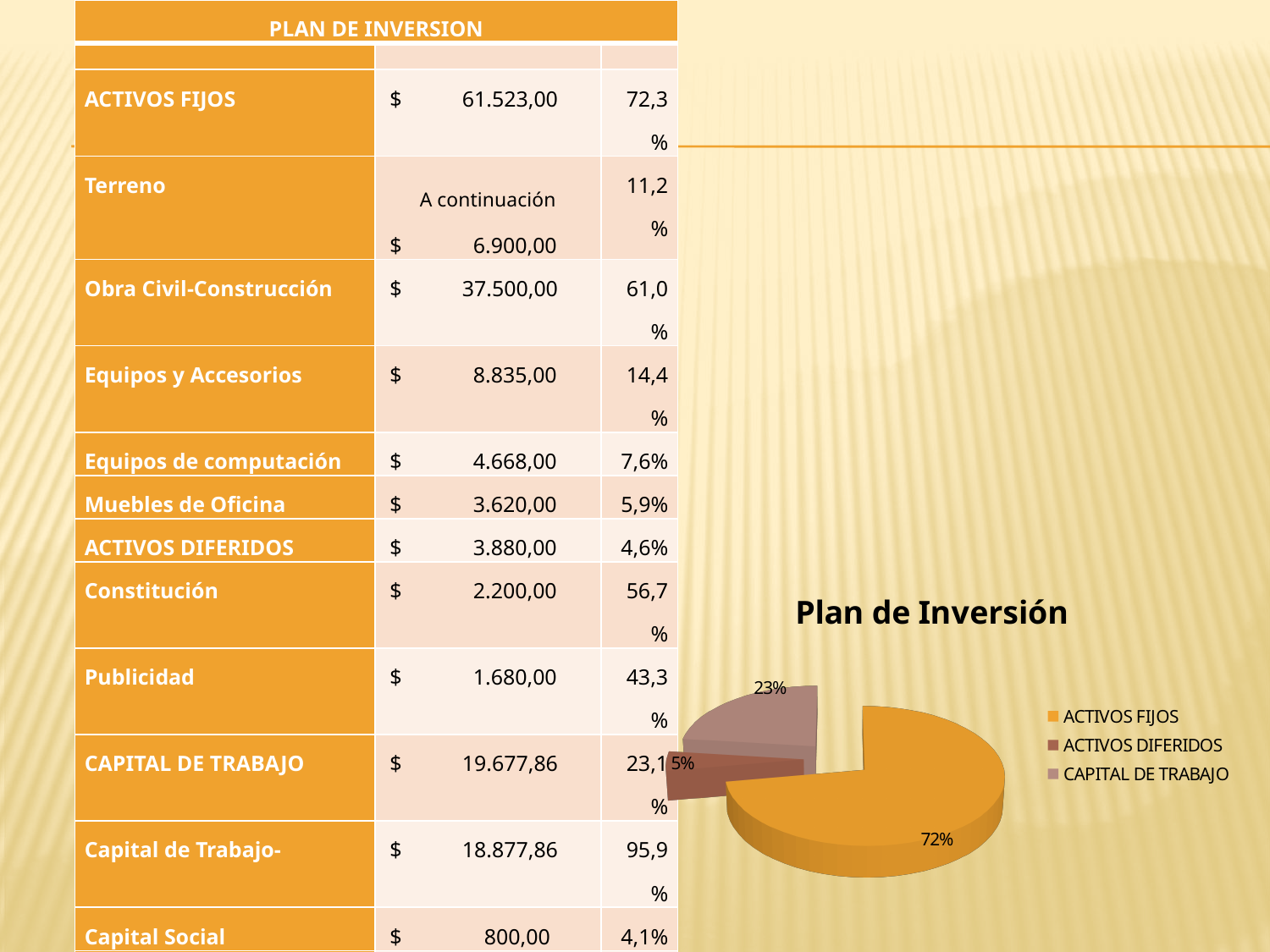
How many entries does the chart legend list? 3 What share of the pie does CAPITAL DE TRABAJO represent? 23% Which legend entry is shown in the orange colour? ACTIVOS FIJOS How many slices does the pie chart have? 3 What is the title of the chart on the slide? Plan de Inversión What kind of chart is shown on the slide? pie chart What share of the pie does ACTIVOS FIJOS represent? 72% Which category has the smallest slice of the pie? ACTIVOS DIFERIDOS Which is larger in the pie chart, CAPITAL DE TRABAJO or ACTIVOS DIFERIDOS? CAPITAL DE TRABAJO Which category has the largest slice of the pie? ACTIVOS FIJOS What share of the pie does ACTIVOS DIFERIDOS represent? 5% What is the difference in percentage points between the ACTIVOS FIJOS slice and the CAPITAL DE TRABAJO slice? 49%